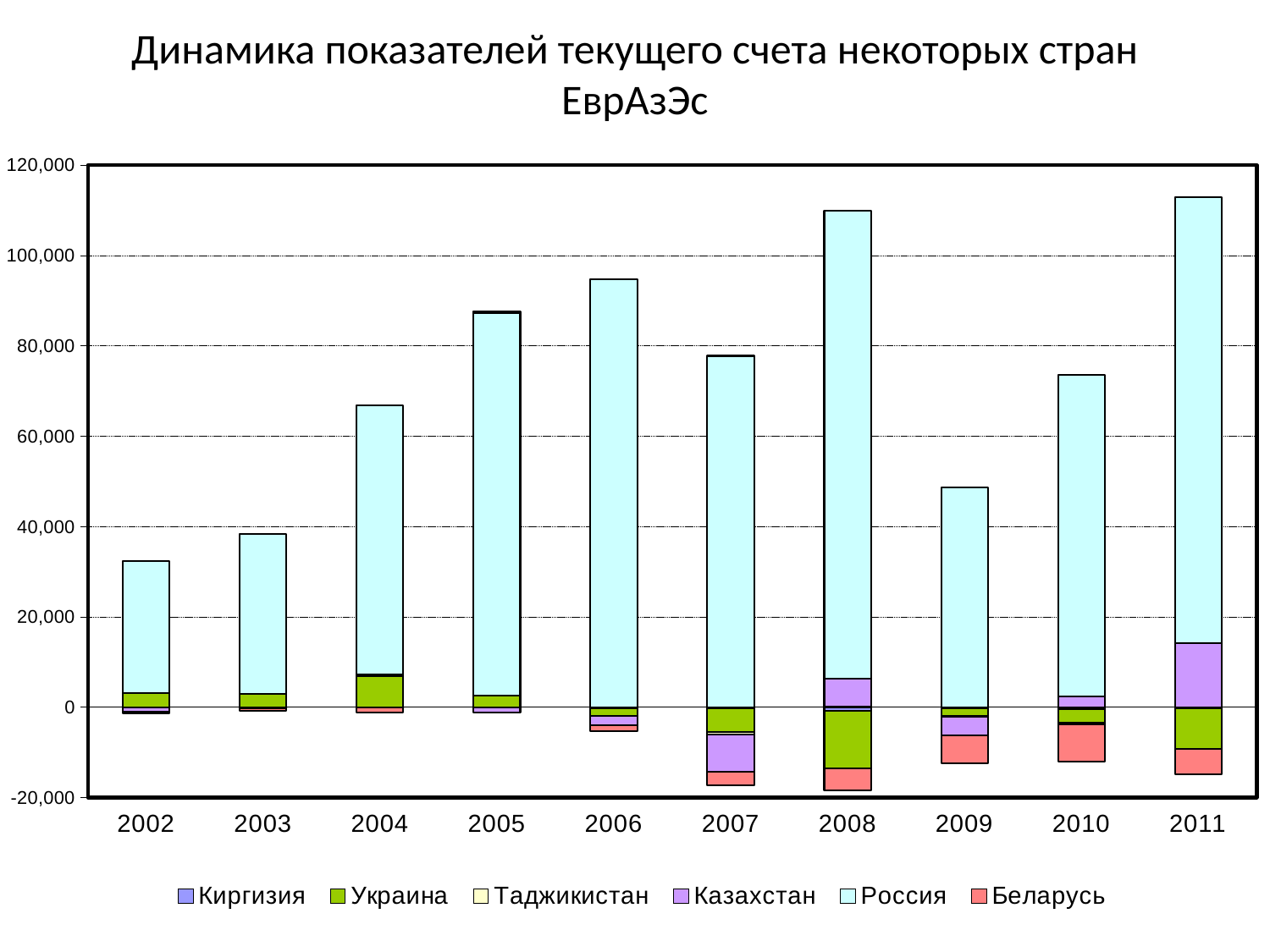
What is the title of the chart? Динамика показателей текущего счета некоторых стран ЕврАзЭс What kind of chart is shown on the slide? Stacked bar chart How many series does the legend list? 6 Is the top of the stacked bar for 2005 greater or less than 80,000? greater Which year has a taller stacked bar above zero, 2009 or 2010? 2010 Which year has a taller stacked bar above zero, 2003 or 2004? 2004 Which series is shown in light cyan in the legend? Россия Is the top of the stacked bar for 2008 greater or less than 100,000? greater Is the top of the stacked bar for 2002 greater or less than 20,000? greater Do the tops of the stacked bars rise or fall from 2002 to 2006? rise How many years are shown on the x axis of the chart? 10